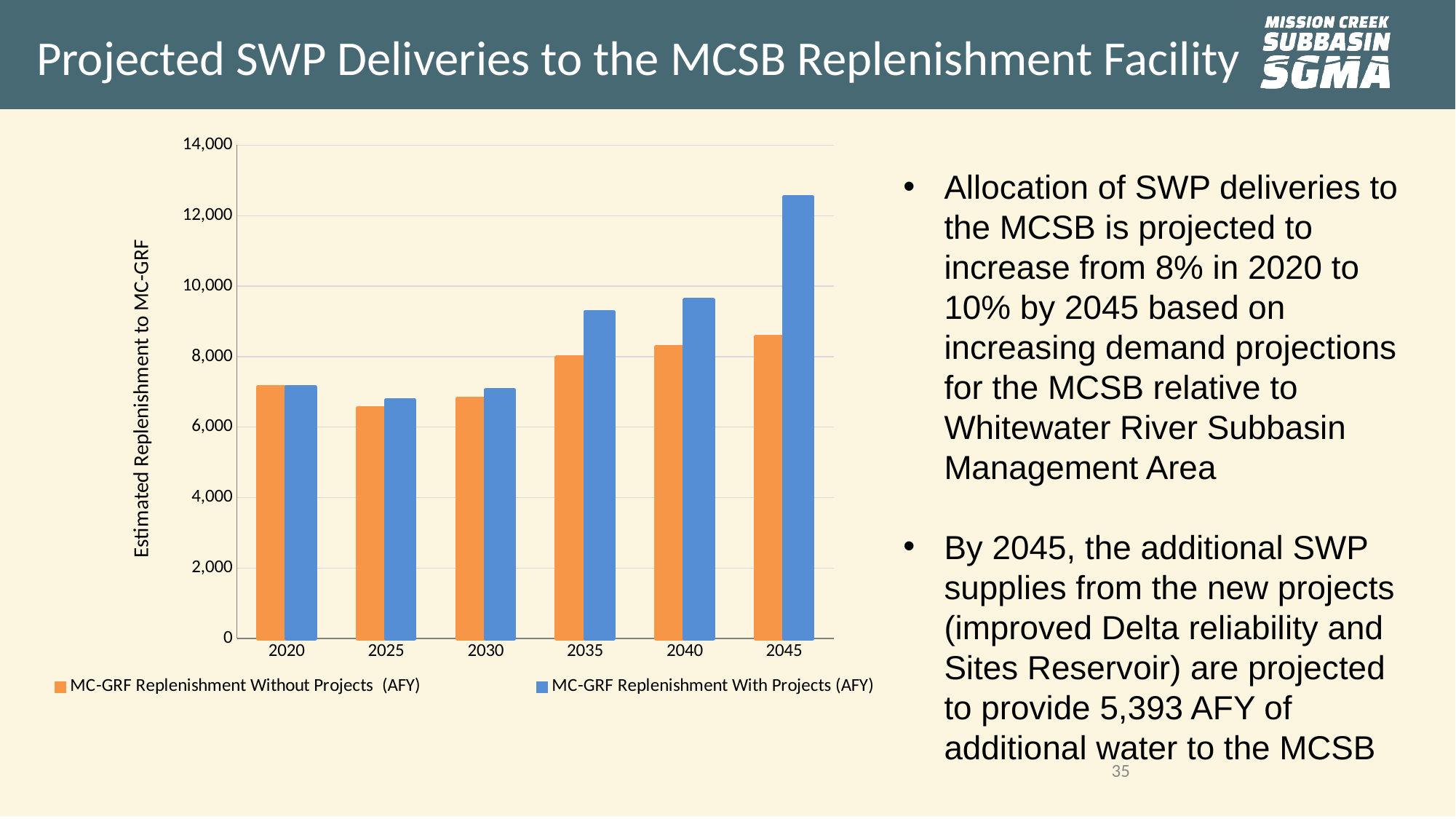
What is the title of the chart's vertical axis? Estimated Replenishment to MC-GRF What kind of chart is shown on the slide? Bar chart Do the MC-GRF Replenishment With Projects (AFY) values rise or fall from 2030 to 2045? Rise Is the MC-GRF Replenishment Without Projects (AFY) value for 2025 greater or less than 8,000? less For 2045, which series has the larger value: MC-GRF Replenishment With Projects (AFY) or MC-GRF Replenishment Without Projects (AFY)? MC-GRF Replenishment With Projects (AFY) In which year is the MC-GRF Replenishment Without Projects (AFY) value lowest? 2025 Is the MC-GRF Replenishment With Projects (AFY) value for 2045 greater or less than 12,000? greater How many series does the chart legend list? 2 Is the MC-GRF Replenishment With Projects (AFY) value for 2040 greater or less than 8,000? greater How many years are shown along the x axis of the chart? 6 In which year is the MC-GRF Replenishment With Projects (AFY) value highest? 2045 Which is larger: the MC-GRF Replenishment With Projects (AFY) value for 2035 or the MC-GRF Replenishment Without Projects (AFY) value for 2040? MC-GRF Replenishment With Projects (AFY) for 2035